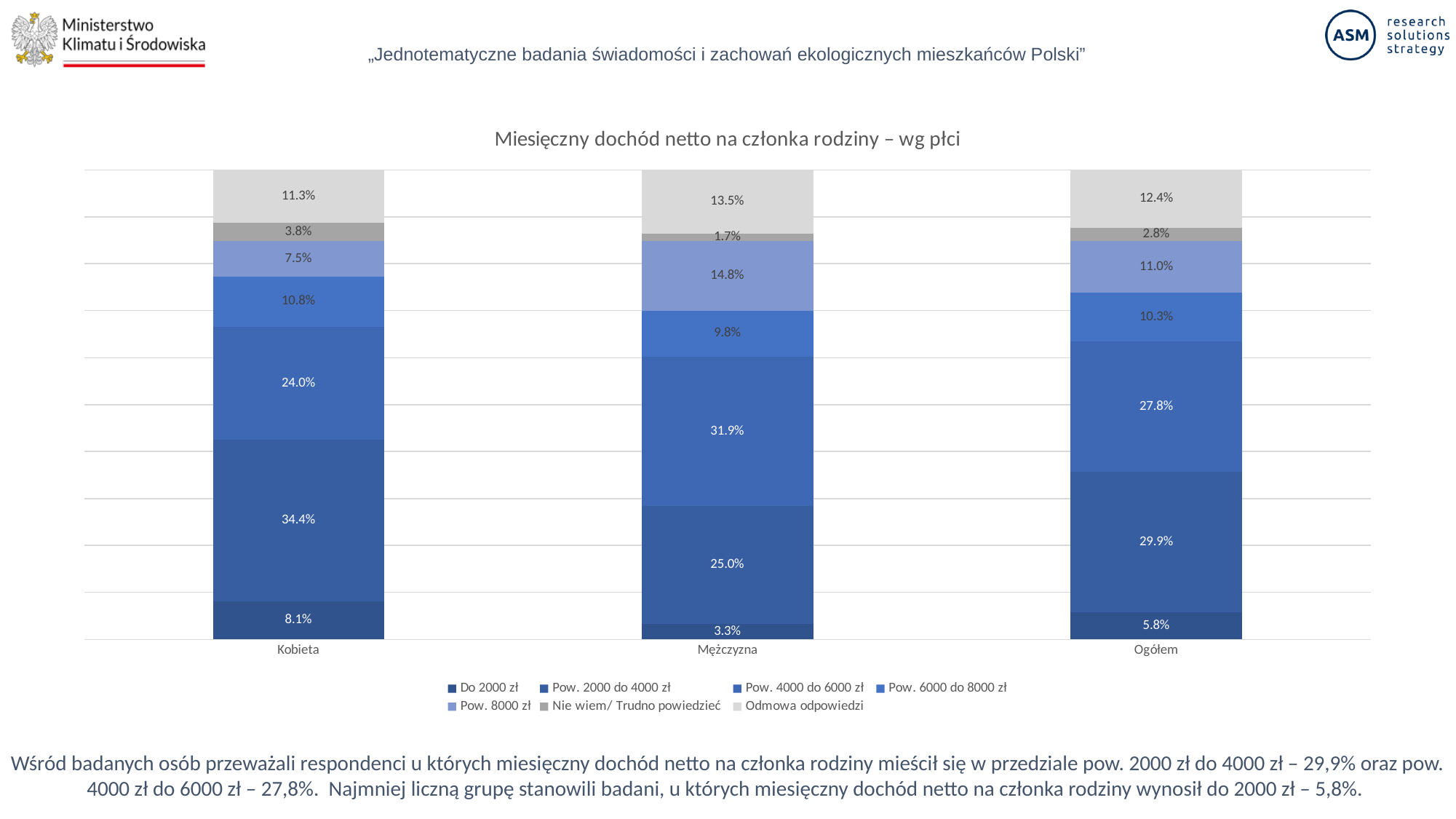
Which category has the highest value for 'Pow. 8000 zł'? Mężczyzna How many series does the legend list? 7 Which is larger: the 'Nie wiem/ Trudno powiedzieć' value for Kobieta or for Ogółem? Kobieta What is the title of the chart? Miesięczny dochód netto na członka rodziny – wg płci How many categories are shown on the x axis? 3 What is the value for 'Pow. 4000 do 6000 zł' in the Mężczyzna bar? 31.9% Which category has the lowest value for 'Do 2000 zł'? Mężczyzna What is the value for 'Do 2000 zł' in the Ogółem bar? 5.8% What type of chart is shown on the slide? Stacked bar chart What is the difference between the 'Pow. 2000 do 4000 zł' values for Kobieta and Mężczyzna? 9.4% What is the value for 'Pow. 2000 do 4000 zł' in the Kobieta bar? 34.4% What is the value for 'Odmowa odpowiedzi' in the Mężczyzna bar? 13.5%